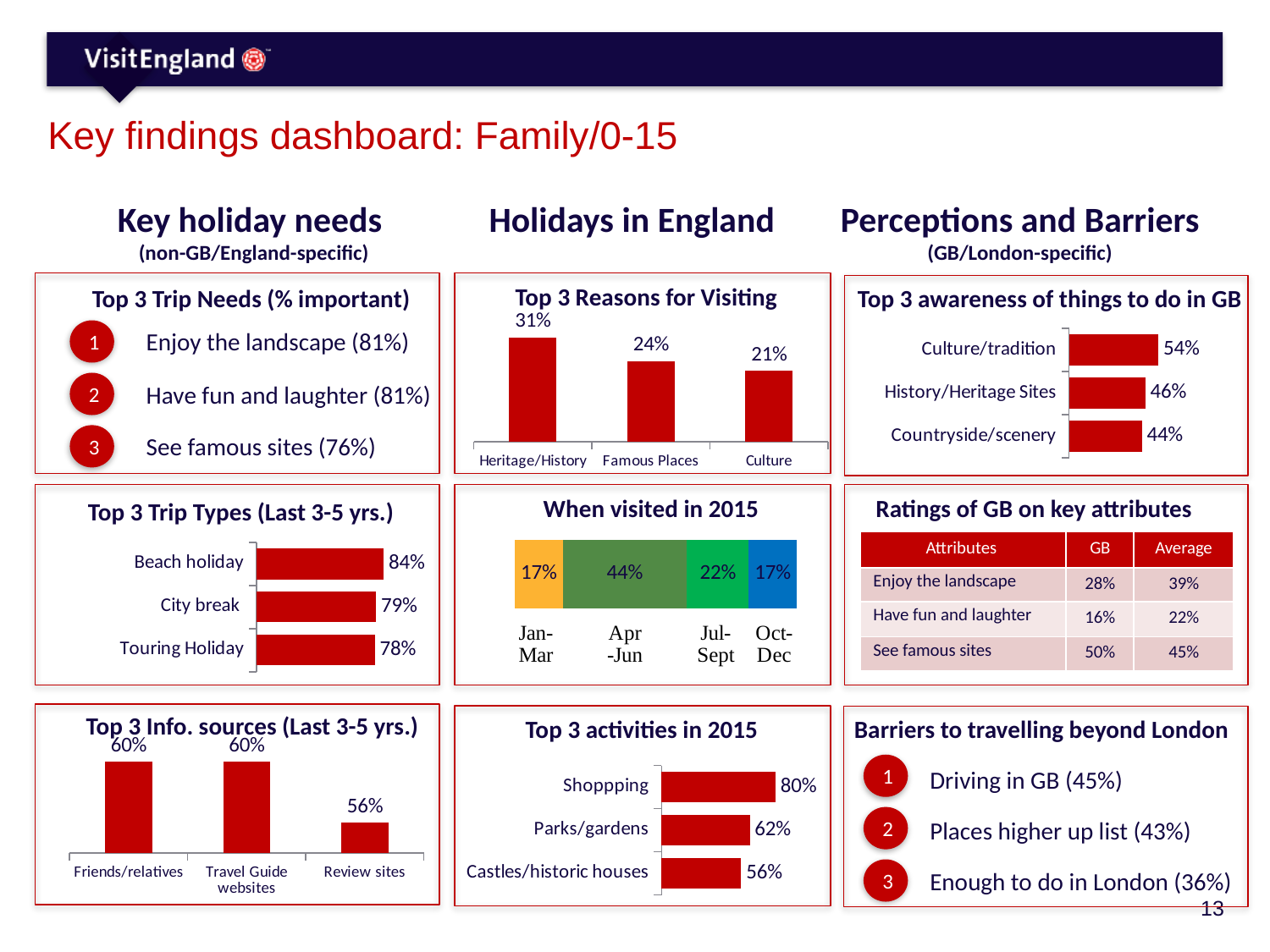
In the 'Top 3 Trip Types (Last 3-5 yrs.)' chart, what is the difference between Beach holiday and Touring Holiday? 6% In the 'When visited in 2015' chart, how many segments are shown? 4 In the 'Top 3 Reasons for Visiting' chart, which category has the lowest value? Culture In the 'When visited in 2015' chart, what is the value for Apr-Jun? 44% In the 'Top 3 Reasons for Visiting' chart, what is the value for Heritage/History? 31% In the 'Top 3 Trip Types (Last 3-5 yrs.)' chart, what is the value for City break? 79% In the 'Top 3 activities in 2015' chart, which is larger, Parks/gardens or Castles/historic houses? Parks/gardens In the 'Top 3 awareness of things to do in GB' chart, which category has the highest value? Culture/tradition In the 'Top 3 awareness of things to do in GB' chart, what is the value for Countryside/scenery? 44% In the 'Top 3 Info. sources (Last 3-5 yrs.)' chart, what is the value for Review sites? 56% In the 'Top 3 activities in 2015' chart, what is the difference between Shoppping and Castles/historic houses? 24% What kind of chart is the 'Top 3 activities in 2015' chart? Bar chart